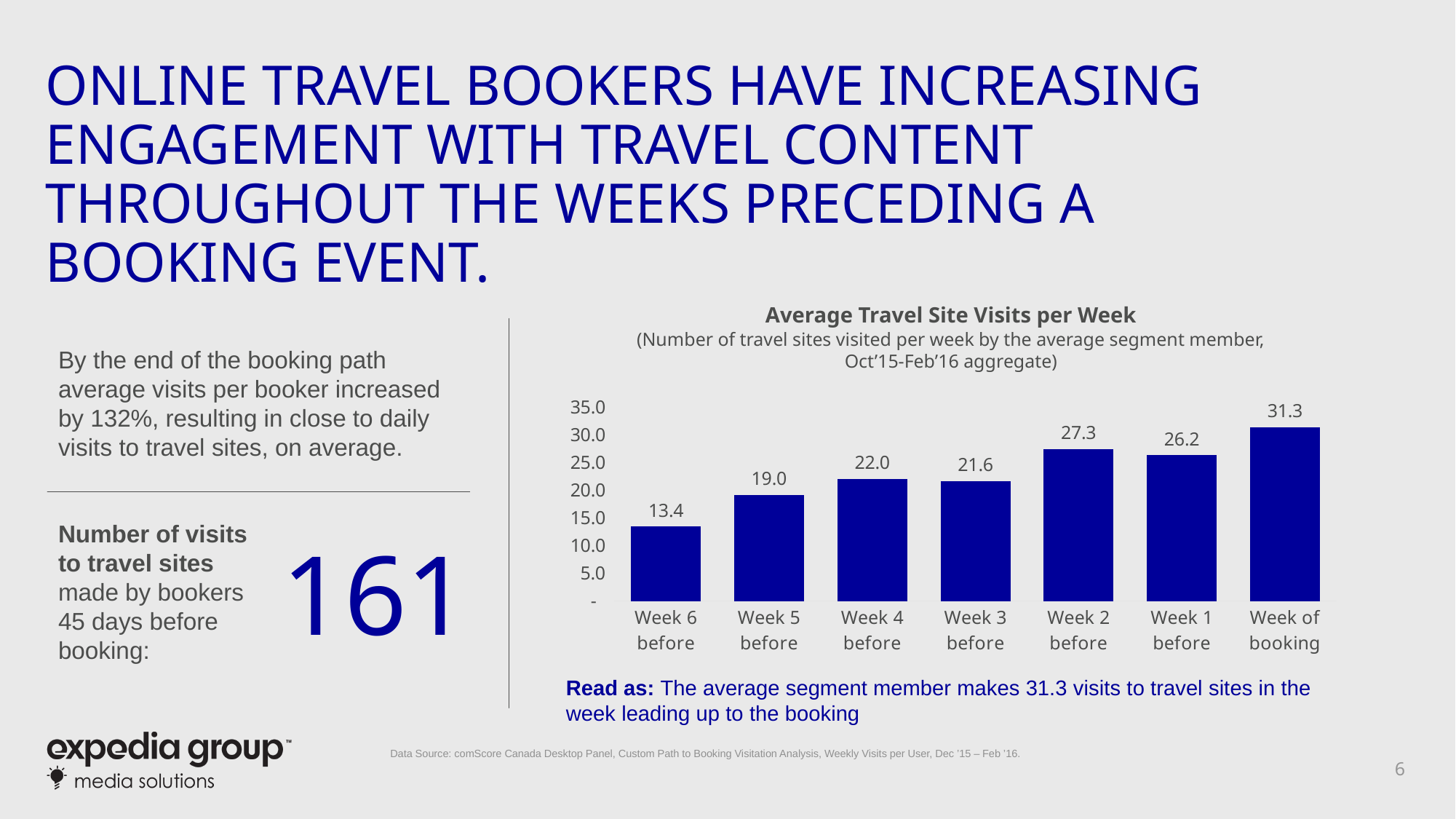
What is the difference between Week 2 before and Week 1 before? 1.1 What is the difference between the Week of booking value and the Week 6 before value? 17.9 How many weeks (categories) are shown on the x axis of the chart? 7 What type of chart is used to show Average Travel Site Visits per Week? Bar chart What is the value shown for the Week of booking? 31.3 Do the values generally rise or fall from Week 6 before to the Week of booking? Rise Which week has the lowest average travel site visits? Week 6 before Which week has the highest average travel site visits? Week of booking Which is larger, the value for Week 4 before or Week 3 before? Week 4 before What is the title of the chart? Average Travel Site Visits per Week What is the average number of travel site visits per week for Week 6 before booking? 13.4 What is the value shown for Week 2 before booking? 27.3